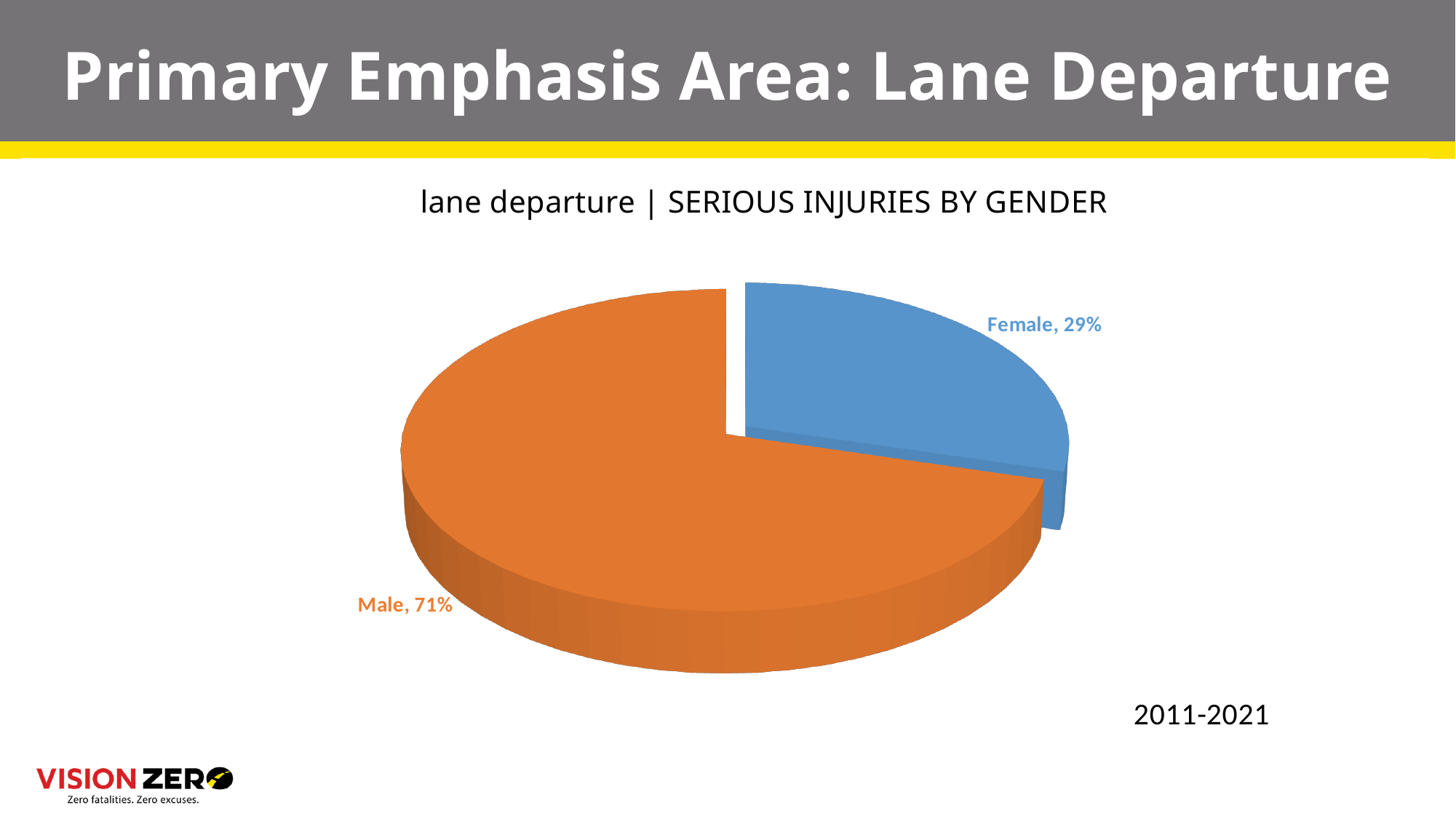
How many slices does the pie chart have? 2 What kind of chart is shown on the slide? Pie chart Is the male share of serious injuries larger or smaller than the female share? Larger Which gender has the larger share of serious injuries in the pie chart? Male What is the difference in percentage points between the male and female shares? 42 percentage points Which gender has the smaller share of serious injuries in the pie chart? Female What share of lane departure serious injuries were female? 29% What colour is the Female slice of the pie chart? Blue Is the female share of serious injuries greater or less than 50%? less What time period does the chart cover? 2011-2021 What share of lane departure serious injuries were male? 71% What is the title of the chart? lane departure | SERIOUS INJURIES BY GENDER